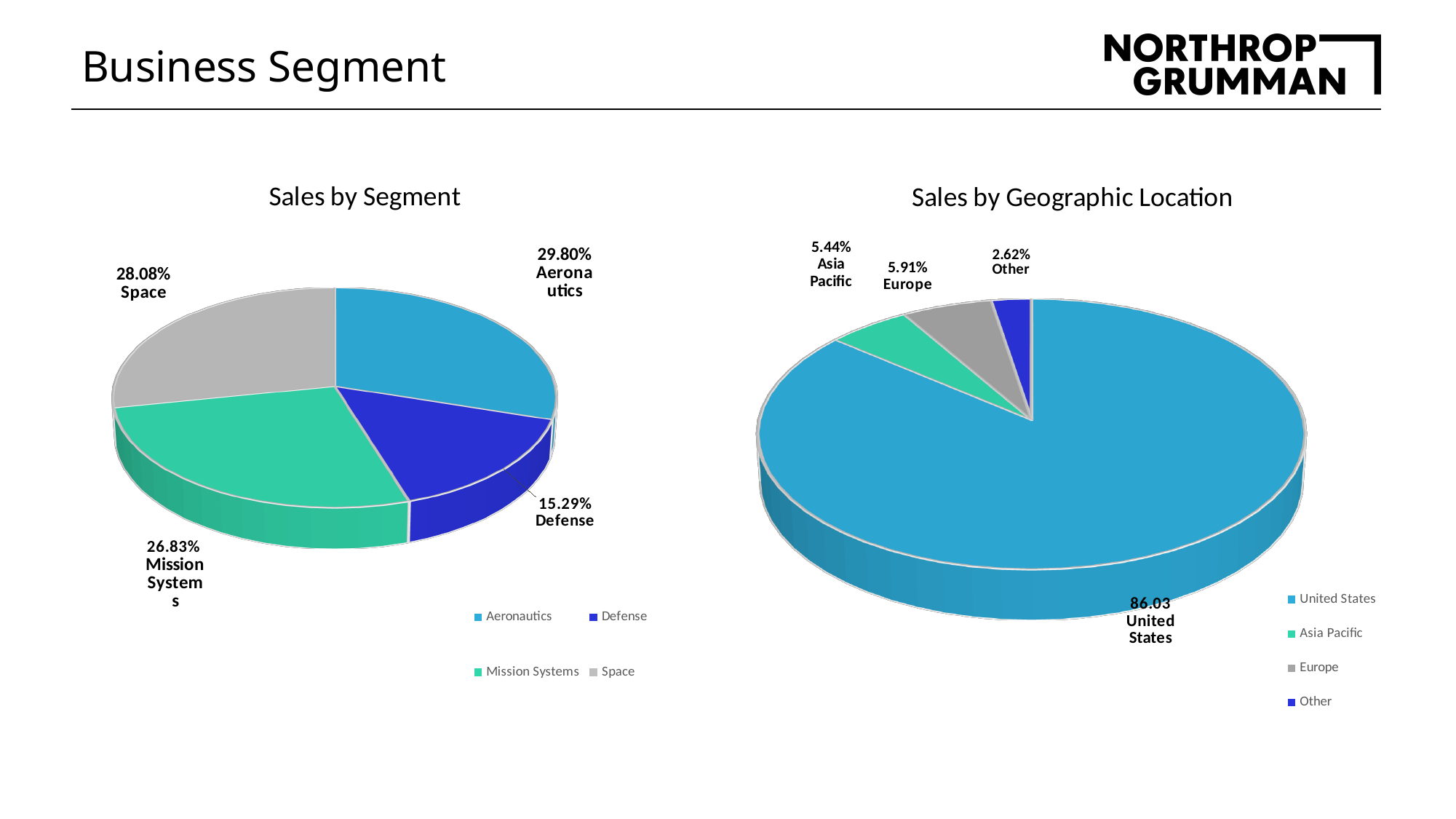
In the Sales by Geographic Location chart, which region has the largest share of sales? United States In the Sales by Segment chart, how many segments are shown? 4 In the Sales by Geographic Location chart, what share of sales comes from Asia Pacific? 5.44% In the Sales by Segment chart, which segment has the smallest share of sales? Defense In the Sales by Segment chart, what is the difference in percentage points between Space and Mission Systems? 1.25 In the Sales by Geographic Location chart, which region has the smallest share of sales? Other In the Sales by Segment chart, which segment has the largest share of sales? Aeronautics In the Sales by Geographic Location chart, what share of sales comes from Europe? 5.91% In the Sales by Segment chart, what share of sales does Defense account for? 15.29% What kind of chart is the Sales by Geographic Location chart? Pie chart In the Sales by Geographic Location chart, how many entries does the legend list? 4 In the Sales by Segment chart, what share of sales does Aeronautics account for? 29.80%